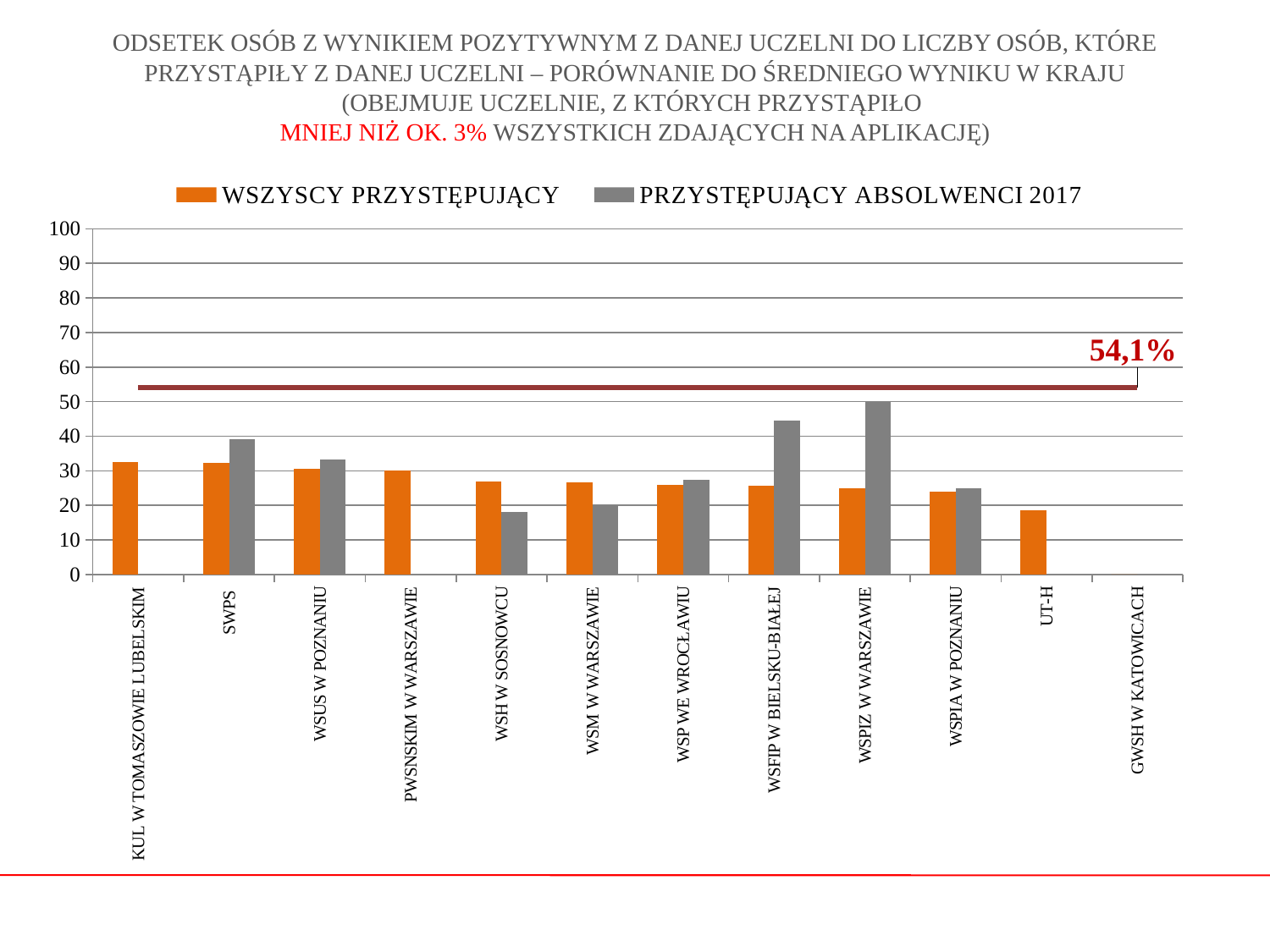
Which colour represents the WSZYSCY PRZYSTĘPUJĄCY series in the legend? orange For WSH W SOSNOWCU, which series has the larger value: WSZYSCY PRZYSTĘPUJĄCY or PRZYSTĘPUJĄCY ABSOLWENCI 2017? WSZYSCY PRZYSTĘPUJĄCY What value is labelled on the horizontal reference line across the chart? 54,1% For SWPS, which series has the larger value: WSZYSCY PRZYSTĘPUJĄCY or PRZYSTĘPUJĄCY ABSOLWENCI 2017? PRZYSTĘPUJĄCY ABSOLWENCI 2017 Is the WSZYSCY PRZYSTĘPUJĄCY value for KUL W TOMASZOWIE LUBELSKIM greater or less than 30? greater How many universities (categories) are shown on the x axis? 12 Which university has the highest value for PRZYSTĘPUJĄCY ABSOLWENCI 2017? WSPIZ W WARSZAWIE Is the PRZYSTĘPUJĄCY ABSOLWENCI 2017 value for WSPIZ W WARSZAWIE greater or less than 40? greater What kind of chart is shown on the slide? bar chart Is the WSZYSCY PRZYSTĘPUJĄCY value for UT-H greater or less than 20? less How many series does the legend list? 2